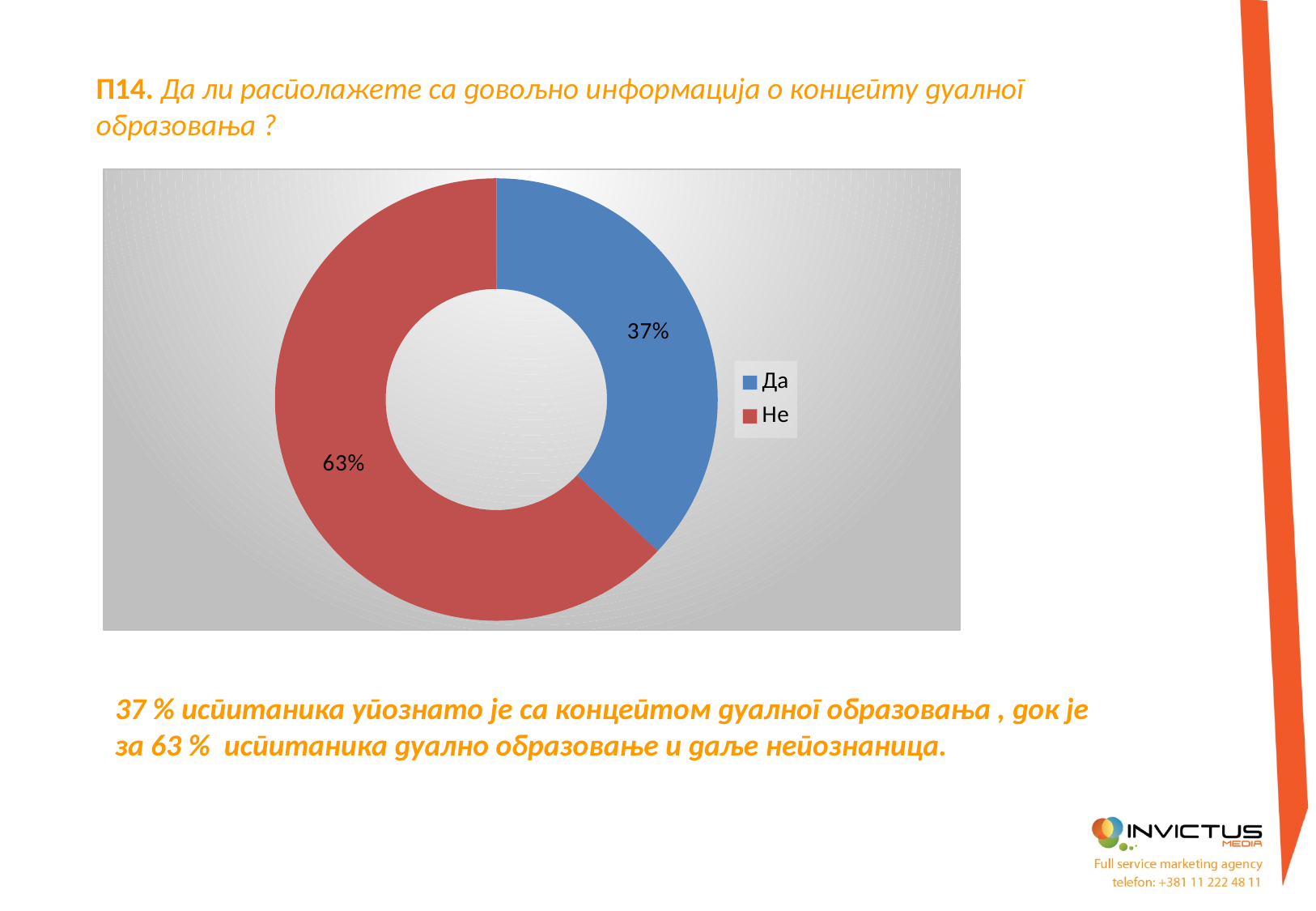
What share of the chart does the "Да" slice represent? 37% Which is larger, the share for "Да" or the share for "Не"? Не Which category has the largest share of the chart? Не What colour is the "Не" slice? Red What percentage of respondents answered "Не" (No)? 63% What percentage of respondents answered "Да" (Yes)? 37% Which category has the smallest share of the chart? Да What colour is the "Да" slice? Blue What kind of chart is shown on the slide? Doughnut (pie) chart How many entries does the legend list? 2 How many categories are shown in the chart? 2 What is the difference in percentage points between the "Не" and "Да" slices? 26